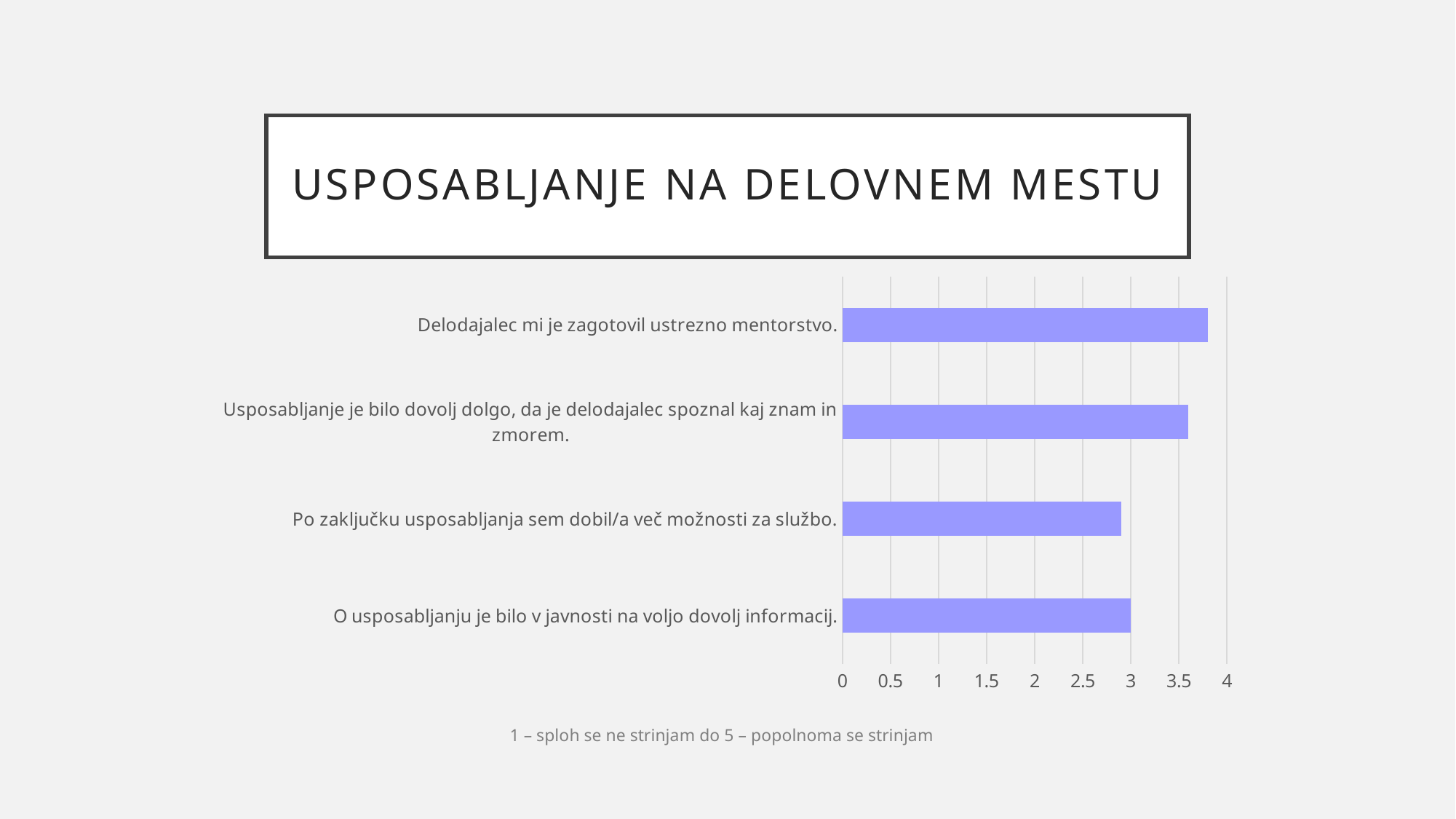
Is the value for "Delodajalec mi je zagotovil ustrezno mentorstvo." greater or less than 3.5? greater Is the value for "Usposabljanje je bilo dovolj dolgo, da je delodajalec spoznal kaj znam in zmorem." greater or less than 3.5? greater How many categories (statements) are plotted in the chart? 4 Which has a larger value: "Usposabljanje je bilo dovolj dolgo, da je delodajalec spoznal kaj znam in zmorem." or "O usposabljanju je bilo v javnosti na voljo dovolj informacij."? Usposabljanje je bilo dovolj dolgo, da je delodajalec spoznal kaj znam in zmorem. Which statement has the highest value in the chart? Delodajalec mi je zagotovil ustrezno mentorstvo. What is the title shown above the chart on the slide? USPOSABLJANJE NA DELOVNEM MESTU Is the value for "Po zaključku usposabljanja sem dobil/a več možnosti za službo." greater or less than 3? less Which has a larger value: "Delodajalec mi je zagotovil ustrezno mentorstvo." or "Po zaključku usposabljanja sem dobil/a več možnosti za službo."? Delodajalec mi je zagotovil ustrezno mentorstvo. What is the highest value shown on the horizontal axis of the chart? 4 What kind of chart is shown on the slide? bar chart